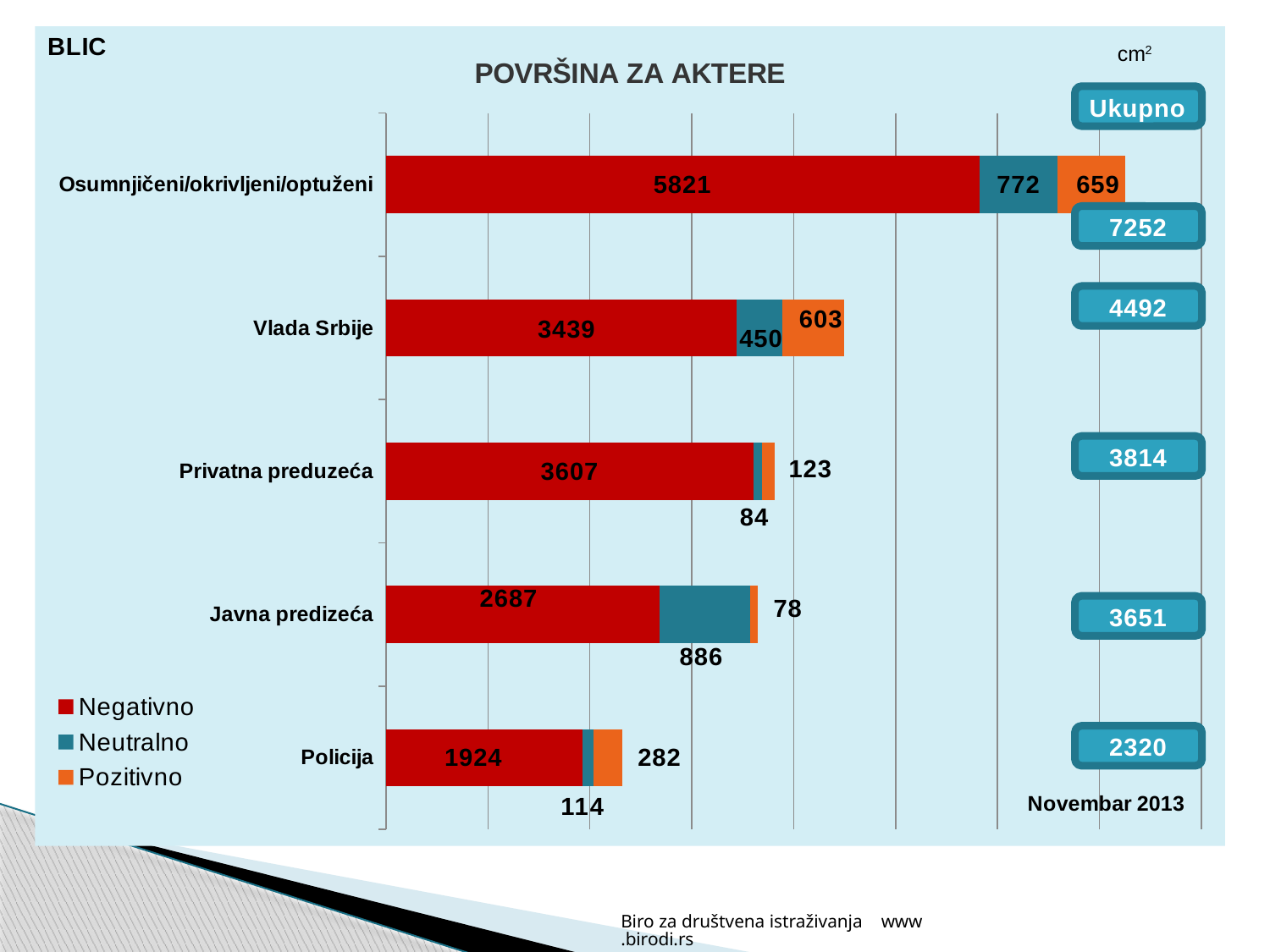
What is the difference between the Negativno values for Osumnjičeni/okrivljeni/optuženi and Vlada Srbije? 2382 What is the Neutralno value for Javna predizeća? 886 What is the Pozitivno value for Policija? 282 How many categories are shown on the chart? 5 How many series does the legend list? 3 What type of chart is shown on the slide? Stacked bar chart Which is larger: the Neutralno value for Vlada Srbije or the Neutralno value for Javna predizeća? Javna predizeća Which category has the lowest Pozitivno value? Javna predizeća What is the total (Ukupno) for Privatna preduzeća? 3814 What is the title of the chart? POVRŠINA ZA AKTERE What is the Negativno value for Vlada Srbije? 3439 Which category has the highest Negativno value? Osumnjičeni/okrivljeni/optuženi